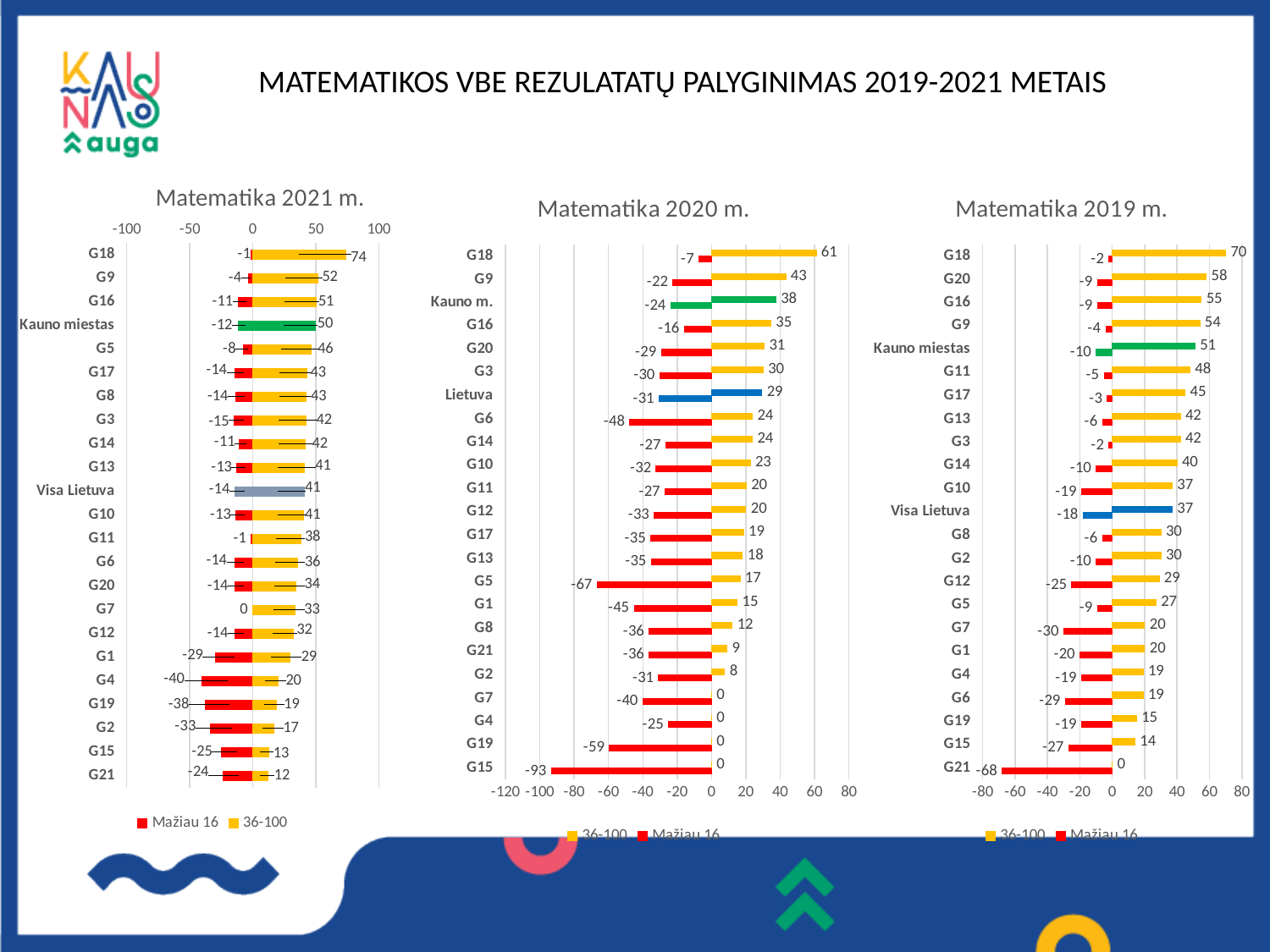
In the 'Matematika 2019 m.' chart, what is the '36-100' value for Kauno miestas? 51 What type of chart is 'Matematika 2020 m.'? Bar chart In the 'Matematika 2019 m.' chart, which category has the lowest 'Mažiau 16' value? G21 In the 'Matematika 2020 m.' chart, which has the larger '36-100' value, G9 or Kauno m.? G9 In the 'Matematika 2021 m.' chart, what is the difference between the '36-100' values for G18 and G21? 62 In the 'Matematika 2021 m.' chart, what is the '36-100' value for G18? 74 In the 'Matematika 2021 m.' chart, what is the 'Mažiau 16' value for G4? -40 In the 'Matematika 2020 m.' chart, what is the 'Mažiau 16' value for G15? -93 What are the two legend entries in the 'Matematika 2019 m.' chart? 36-100 and Mažiau 16 How many series does the legend of the 'Matematika 2021 m.' chart list? 2 How many categories are shown in the 'Matematika 2019 m.' chart? 23 In the 'Matematika 2020 m.' chart, which category has the highest '36-100' value? G18